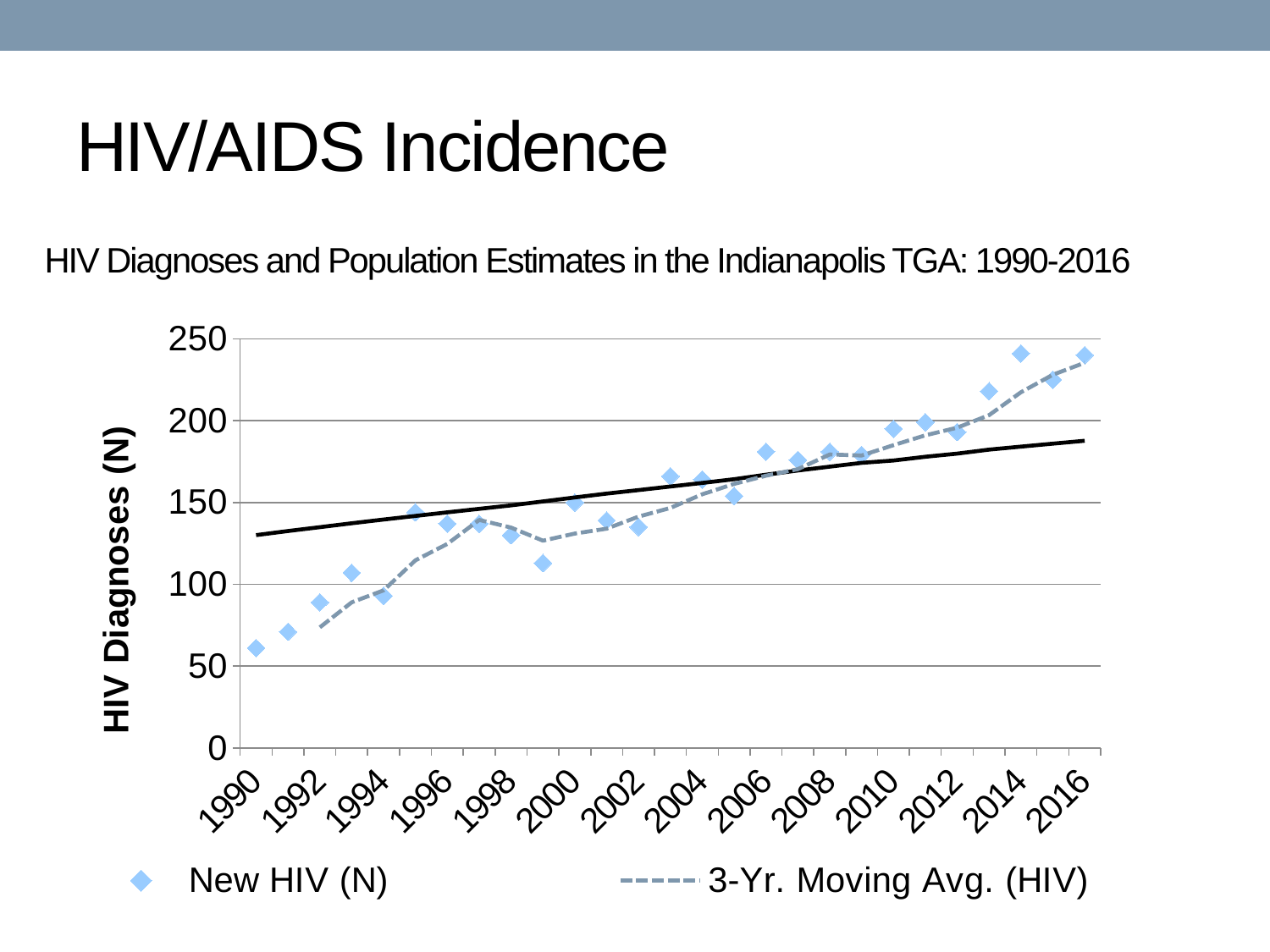
How many series does the chart's legend list? 2 Is the New HIV (N) value for 2006 greater or less than 150? greater Which year has the lowest New HIV (N) value? 1990 Over how many years (data points) are New HIV (N) values plotted, from 1990 to 2016? 27 What is the title of the chart? HIV Diagnoses and Population Estimates in the Indianapolis TGA: 1990-2016 Do the New HIV (N) values generally rise or fall from 1990 to 2016? rise Which is larger, the New HIV (N) value for 1990 or for 2014? 2014 Is the New HIV (N) value for 1992 greater or less than 100? less Is the New HIV (N) value for 1990 greater or less than 100? less What is the label on the vertical axis of the chart? HIV Diagnoses (N)